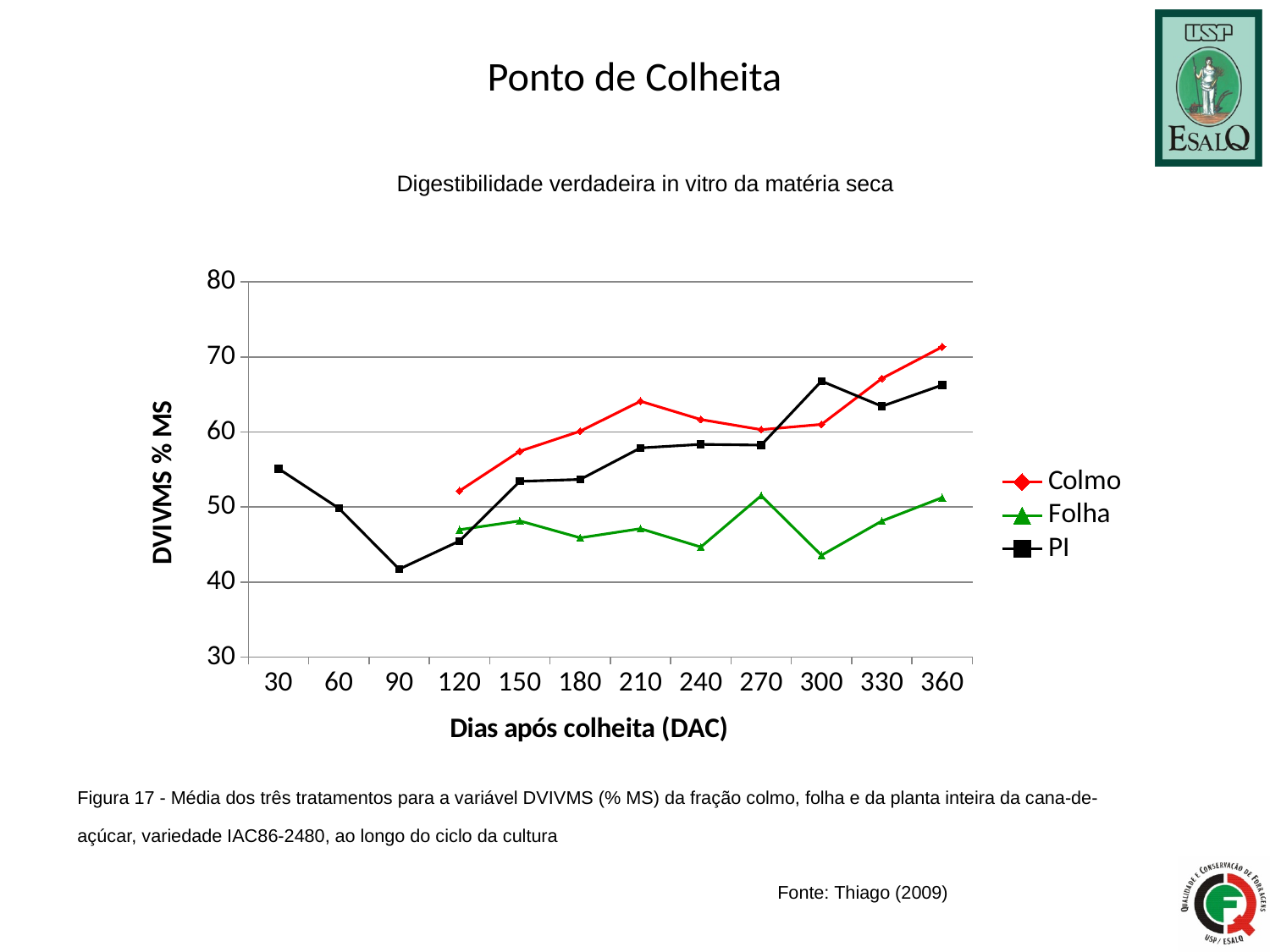
Is the value for PI at 90 DAC greater or less than 50? less Is the value for Folha at 300 DAC greater or less than 50? less What kind of chart is shown on the slide? line chart What is the label of the y axis? DVIVMS % MS At 300 DAC, which is larger: PI or Colmo? PI Does the Colmo series rise or fall from 300 DAC to 360 DAC? rise How many points are marked along the x axis (Dias após colheita)? 12 Is the value for Colmo at 360 DAC greater or less than 70? greater How many series does the legend list? 3 At which DAC does the PI series reach its lowest value? 90 Which series has the highest value at 360 DAC? Colmo